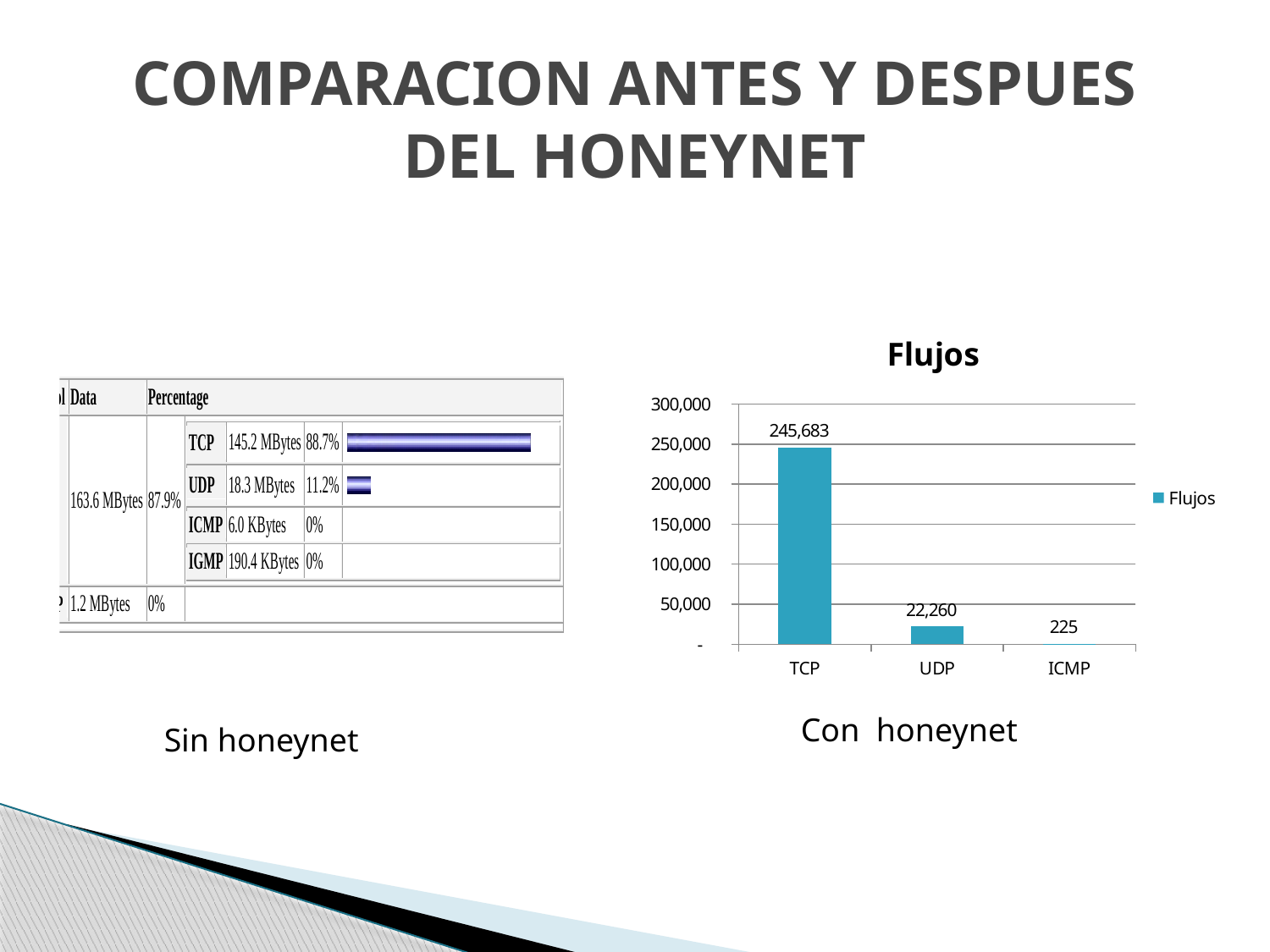
What kind of chart is the Flujos chart? bar chart In the Flujos chart, which category has the highest value? TCP In the Flujos chart, what is the value for ICMP? 225 In the Flujos chart, what is the value for UDP? 22,260 In the Flujos chart, which category has the lowest value? ICMP In the Flujos chart, which is larger, the value for UDP or the value for ICMP? UDP In the Flujos chart, what is the value for TCP? 245,683 How many series does the legend of the Flujos chart list? 1 How many categories are shown on the x axis of the Flujos chart? 3 In the Flujos chart, what is the difference between the values for UDP and ICMP? 22,035 In the Flujos chart, what is the difference between the values for TCP and UDP? 223,423 In the Flujos chart, is the value for TCP greater or less than 200,000? greater